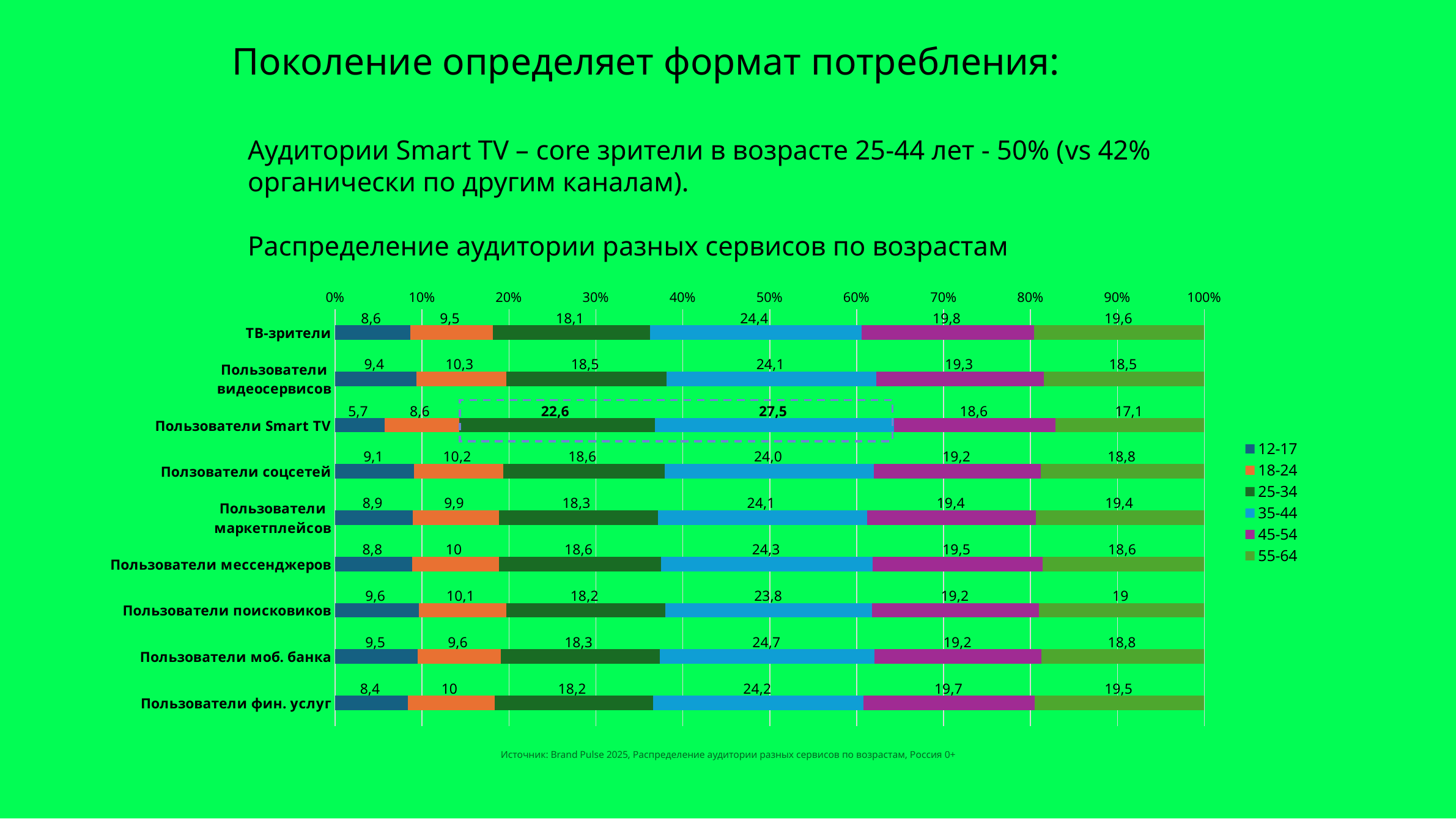
Which category has the highest value for the 35-44 series? Пользователи Smart TV What is the value of the 35-44 series for Пользователи Smart TV? 27,5 How many categories (rows) are shown in the chart? 9 Which category has the lowest value for the 12-17 series? Пользователи Smart TV What is the difference between the 25-34 value for Пользователи Smart TV and the 25-34 value for ТВ-зрители? 4,5 Which age group does the legend list last? 55-64 What is the value of the 12-17 series for ТВ-зрители? 8,6 Which is larger: the 55-64 value for ТВ-зрители or the 55-64 value for Пользователи Smart TV? ТВ-зрители What is the value of the 18-24 series for Пользователи видеосервисов? 10,3 What is the value of the 55-64 series for Пользователи фин. услуг? 19,5 What kind of chart is shown on the slide? Stacked bar chart How many series does the legend list? 6